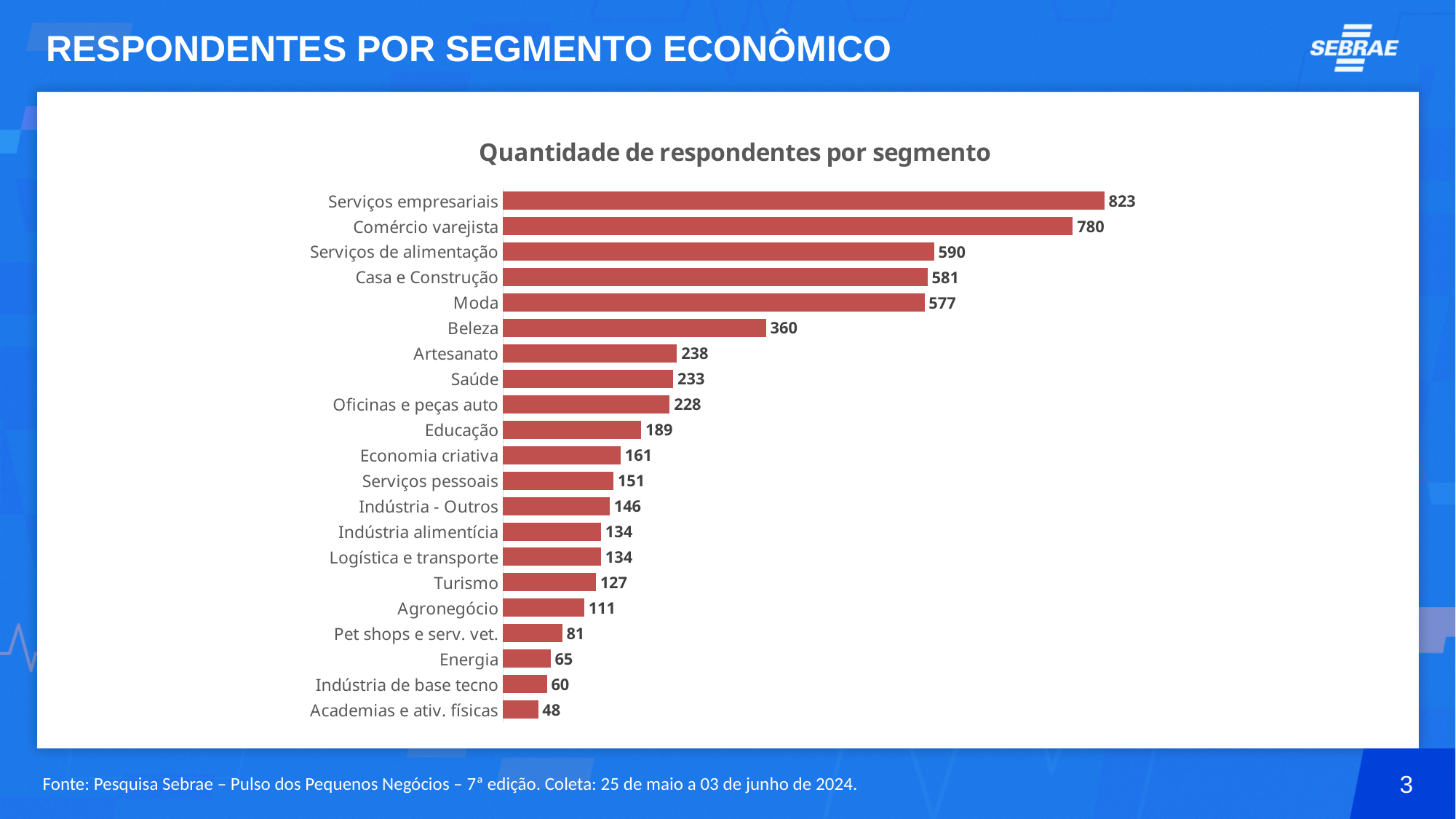
How many segments are shown in the chart? 21 What type of chart is shown on the slide? Bar chart What is the title of the chart? Quantidade de respondentes por segmento What is the difference in respondents between Beleza and Artesanato? 122 Which has more respondents, Energia or Agronegócio? Agronegócio Which segment has the lowest number of respondents? Academias e ativ. físicas What is the number of respondents for Beleza? 360 Which has more respondents, Educação or Economia criativa? Educação What is the number of respondents for Turismo? 127 What is the number of respondents for Comércio varejista? 780 Which segment has the highest number of respondents? Serviços empresariais What is the difference in respondents between Serviços empresariais and Comércio varejista? 43